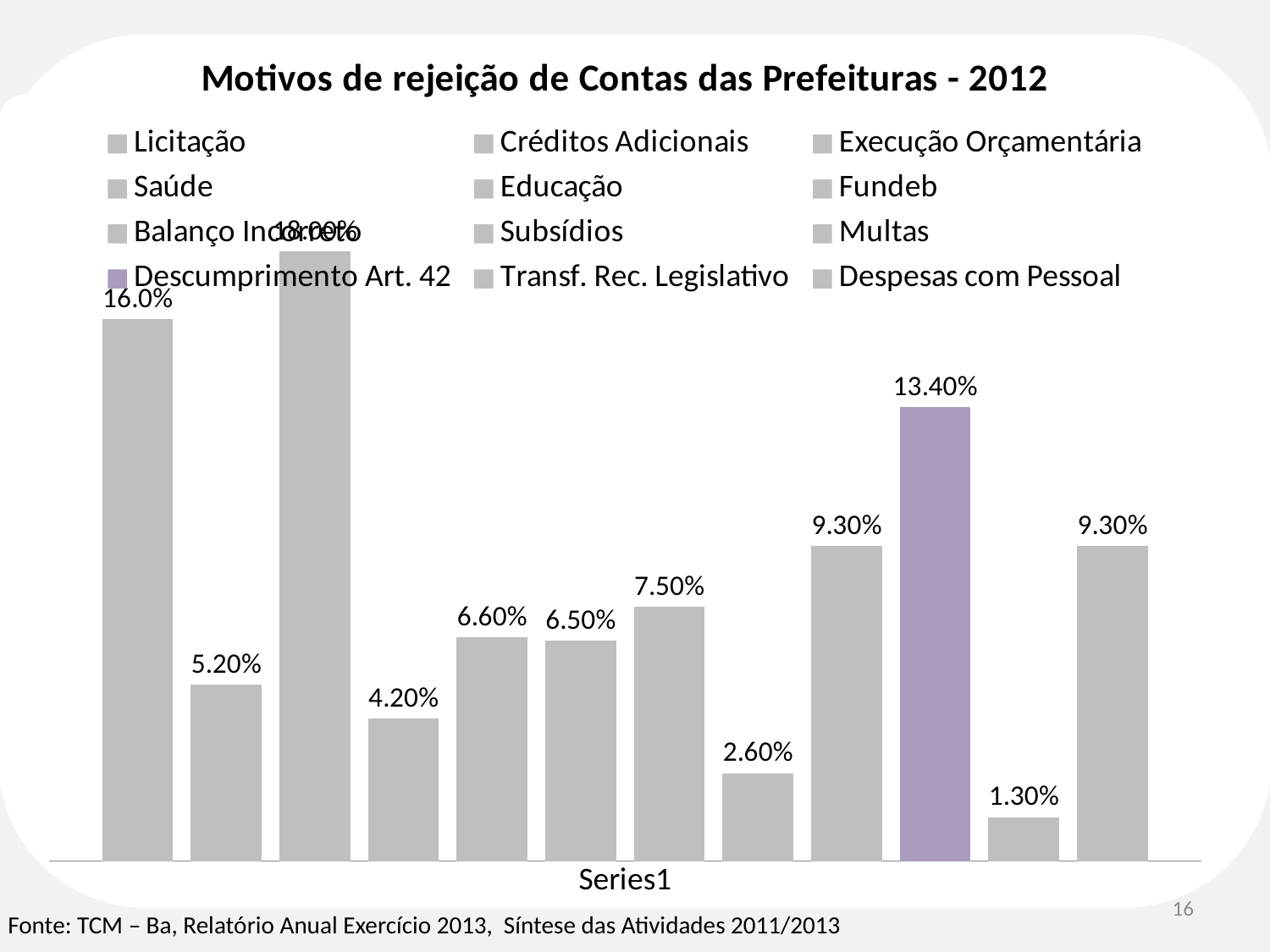
How many bars are plotted in the chart? 12 Which category has the lowest value in the chart? Transf. Rec. Legislativo Which category has the highest value in the chart? Execução Orçamentária What is the title of the chart? Motivos de rejeição de Contas das Prefeituras - 2012 Which category is shown with a purple bar instead of a grey one? Descumprimento Art. 42 Which is larger, the value for Execução Orçamentária or the value for Saúde? Execução Orçamentária What is the value shown for Balanço Incorreto? 7.50% What is the difference between the values for Multas and Subsídios? 6.70% What is the value shown for Descumprimento Art. 42? 13.40% How many entries does the chart legend list? 12 What is the value shown for Licitação? 16.0% What kind of chart is shown on the slide? Bar chart